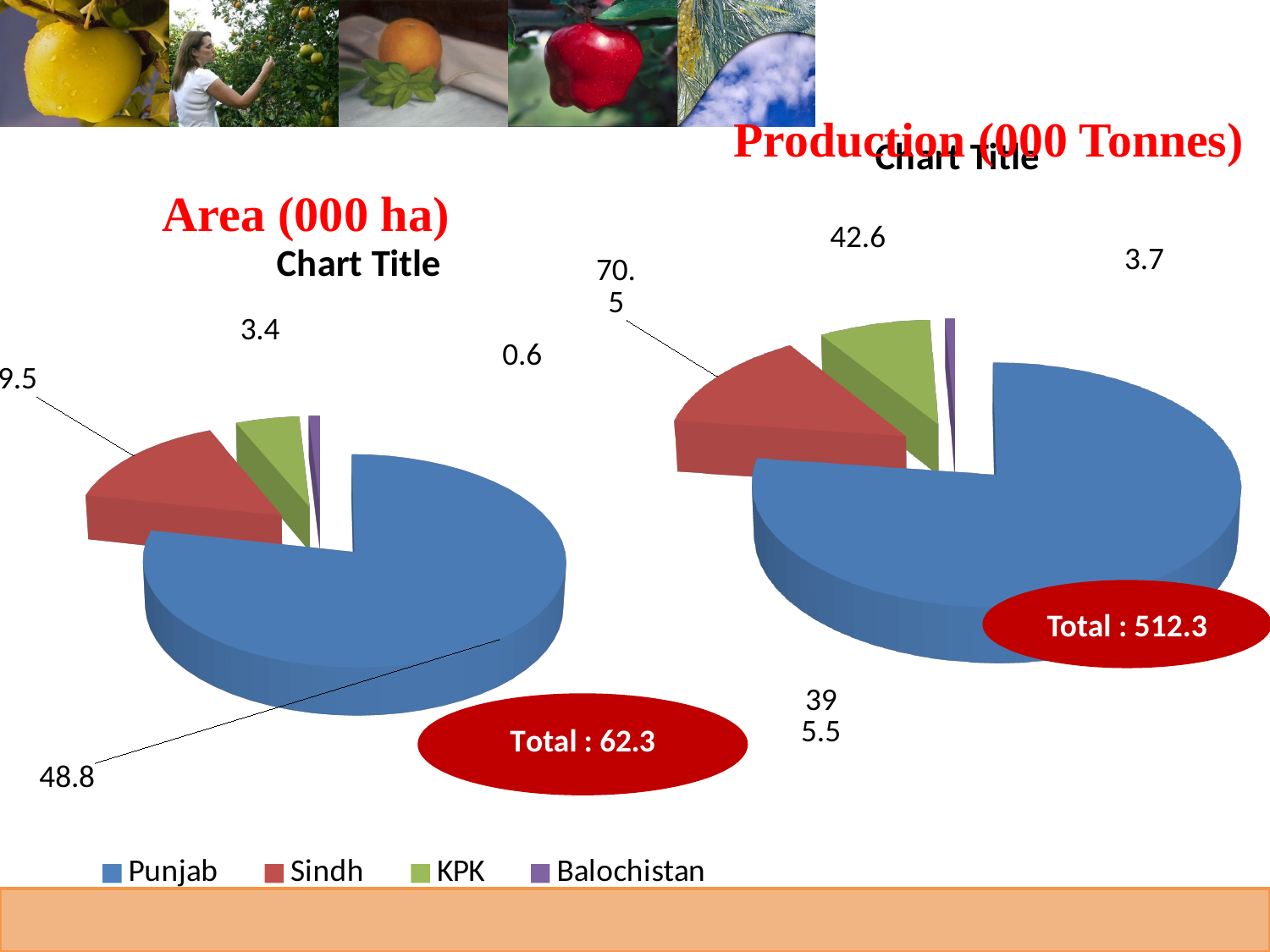
In the Production (000 Tonnes) chart, which province has the smallest slice? Balochistan In the Production (000 Tonnes) chart, what is the value for Balochistan? 3.7 In the Area (000 ha) chart, what is the value for Balochistan? 0.6 What kind of chart is the Area (000 ha) chart? Pie chart What total is shown for the Area (000 ha) chart? 62.3 What total is shown for the Production (000 Tonnes) chart? 512.3 In the Area (000 ha) chart, which province has the largest slice? Punjab In the Production (000 Tonnes) chart, what is the value for KPK? 42.6 In the Area (000 ha) chart, what is the value for Punjab? 48.8 In the Area (000 ha) chart, what is the value for KPK? 3.4 In the Area (000 ha) chart, what is the difference between the values for KPK and Balochistan? 2.8 How many provinces does the legend list? 4